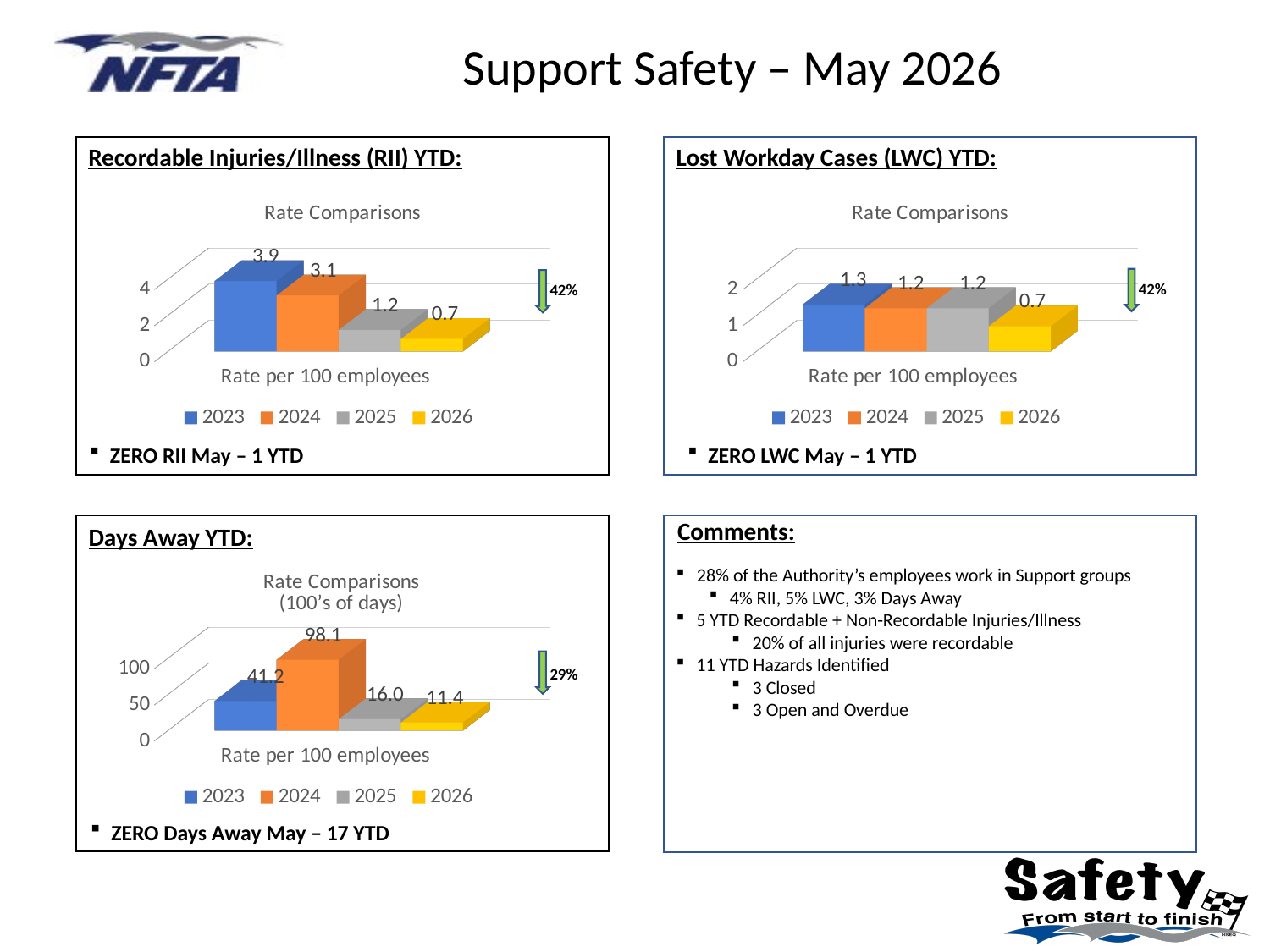
In the Lost Workday Cases (LWC) YTD chart, what is the value for 2023? 1.3 In the Recordable Injuries/Illness (RII) YTD chart, what is the value for 2023? 3.9 In the Days Away YTD chart, which is larger, the value for 2025 or the value for 2026? 2025 In the Lost Workday Cases (LWC) YTD chart, how many series does the legend list? 4 In the Recordable Injuries/Illness (RII) YTD chart, what is the value for 2026? 0.7 In the Days Away YTD chart, which year has the highest value? 2024 What kind of chart is the Days Away YTD chart? Bar chart In the Days Away YTD chart, what is the value for 2025? 16.0 In the Recordable Injuries/Illness (RII) YTD chart, which year has the lowest value? 2026 In the Recordable Injuries/Illness (RII) YTD chart, what is the difference between the 2023 and 2024 values? 0.8 In the Lost Workday Cases (LWC) YTD chart, what is the value for 2026? 0.7 In the Days Away YTD chart, what is the difference between the 2024 and 2023 values? 56.9